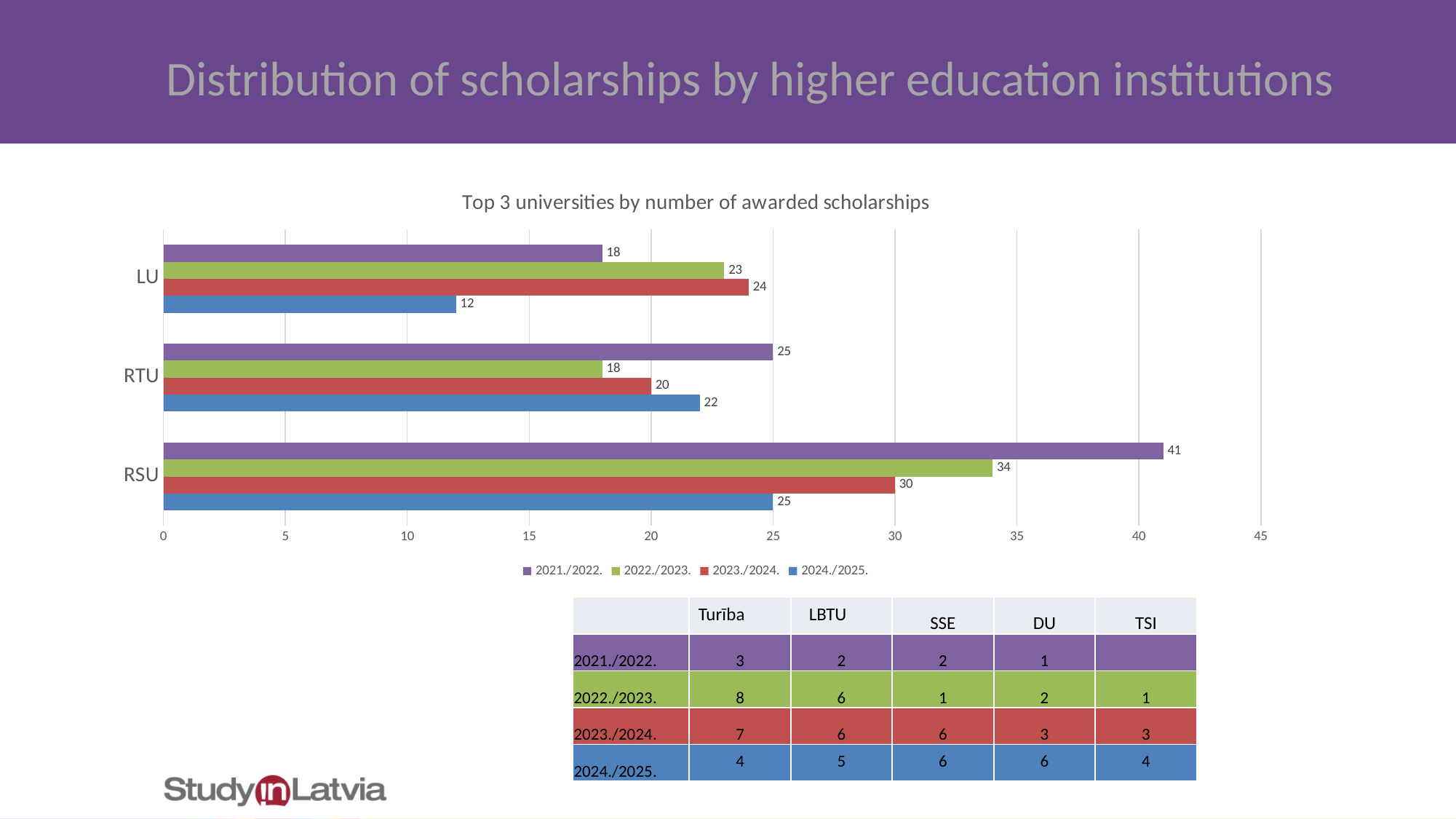
What is the title of the chart? Top 3 universities by number of awarded scholarships What is the difference between the 2021./2022. and 2024./2025. values for RSU? 16 Which university has the highest value in the 2022./2023. series? RSU What is the value for RSU in the 2021./2022. series? 41 Which is larger for RTU: the 2021./2022. value or the 2022./2023. value? 2021./2022. How many series does the legend list? 4 Is the value for RSU in the 2021./2022. series greater or less than 40? greater What is the value for RTU in the 2023./2024. series? 20 Which university has the lowest value in the 2024./2025. series? LU What kind of chart is shown on the slide? bar chart What is the value for LU in the 2024./2025. series? 12 How many universities are shown on the chart? 3